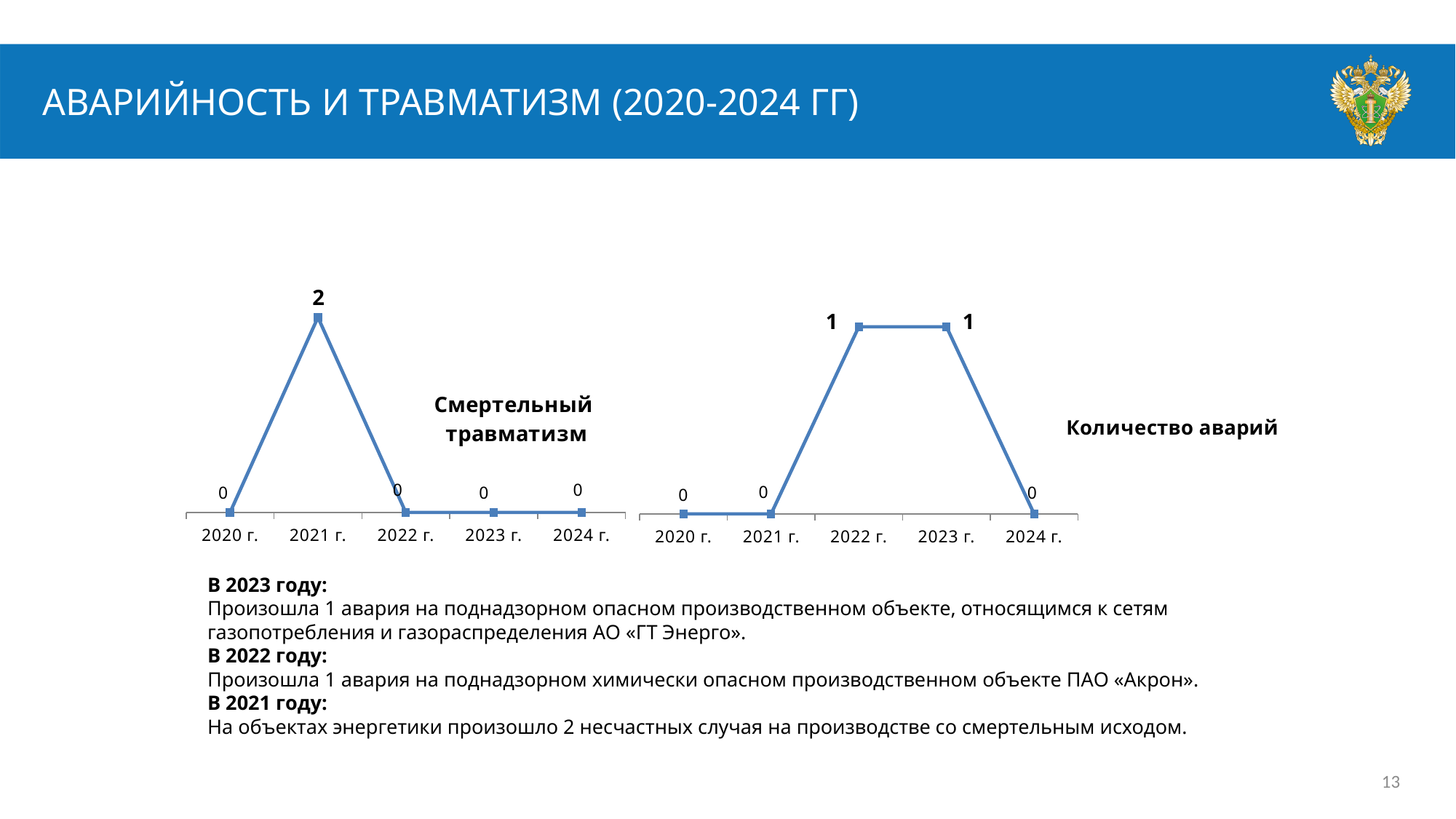
In the 'Количество аварий' chart, what is the value for 2022 г.? 1 In the 'Смертельный травматизм' chart, what is the value for 2021 г.? 2 How many years are plotted in the 'Смертельный травматизм' chart? 5 In the 'Смертельный травматизм' chart, what is the value for 2023 г.? 0 In the 'Смертельный травматизм' chart, which year has the highest value? 2021 г. In the 'Количество аварий' chart, which is larger, the value for 2021 г. or the value for 2022 г.? 2022 г. What type of chart is the 'Количество аварий' chart? Line chart In the 'Количество аварий' chart, does the value rise or fall from 2023 г. to 2024 г.? Fall In the 'Смертельный травматизм' chart, what is the difference between the values for 2021 г. and 2022 г.? 2 In the 'Количество аварий' chart, which year has the highest value? 2022 г. and 2023 г. In the 'Количество аварий' chart, what is the value for 2024 г.? 0 In the 'Количество аварий' chart, what is the difference between the values for 2023 г. and 2024 г.? 1